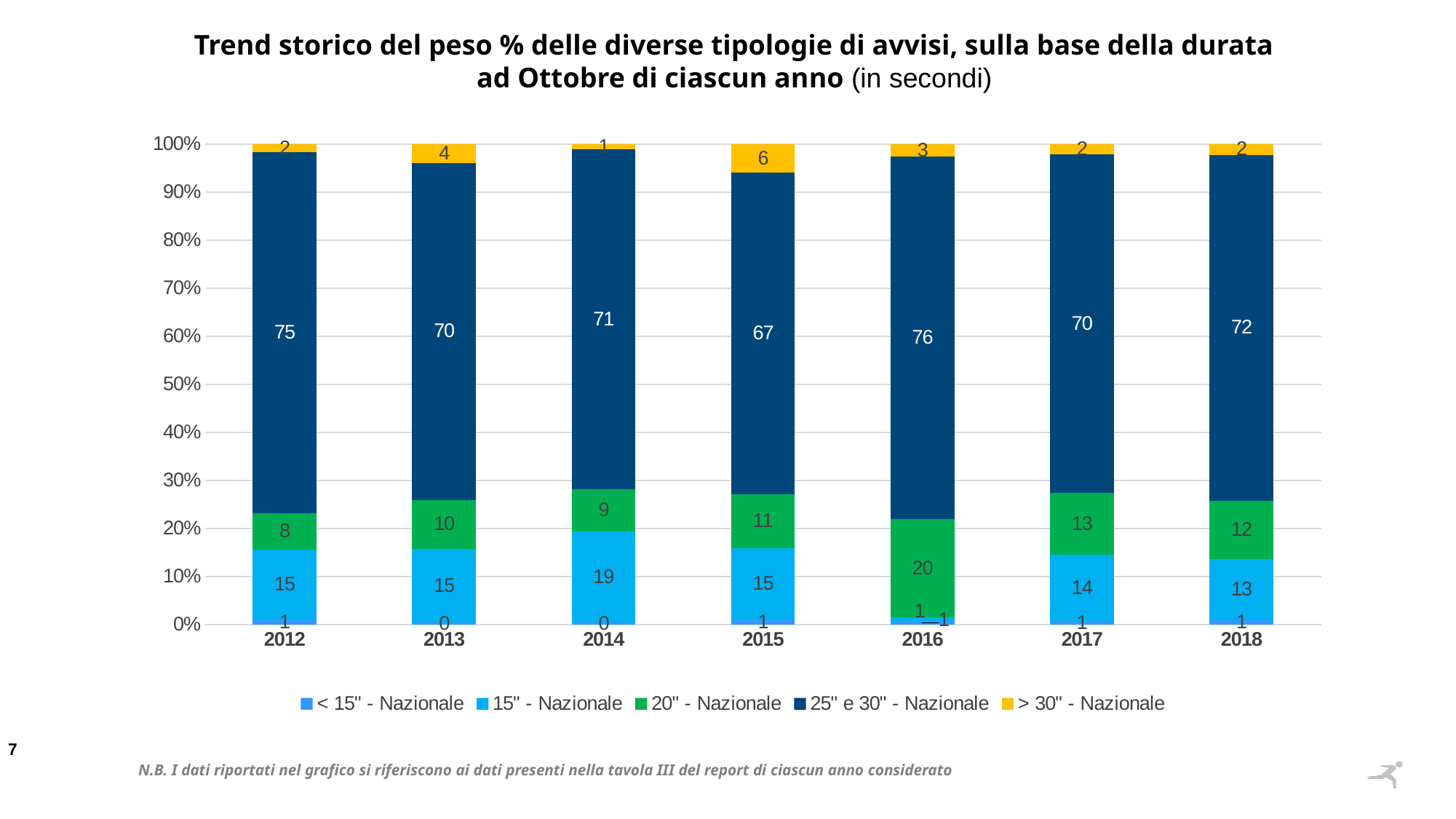
What is the value for the "> 30'' - Nazionale" series in 2015? 6 What kind of chart is shown on the slide? stacked bar chart How many series does the legend list? 5 What is the value for the "20'' - Nazionale" series in 2017? 13 In which year is the "25'' e 30'' - Nazionale" series lowest? 2015 How many years are shown on the x axis of the chart? 7 Which series is shown in yellow in the legend? > 30'' - Nazionale What is the value for the "25'' e 30'' - Nazionale" series in 2016? 76 What is the value for the "15'' - Nazionale" series in 2014? 19 In which year is the "25'' e 30'' - Nazionale" series highest? 2016 Which is larger: the "15'' - Nazionale" value in 2013 or in 2018? 2013 What is the difference between the "20'' - Nazionale" value in 2016 and in 2012? 12